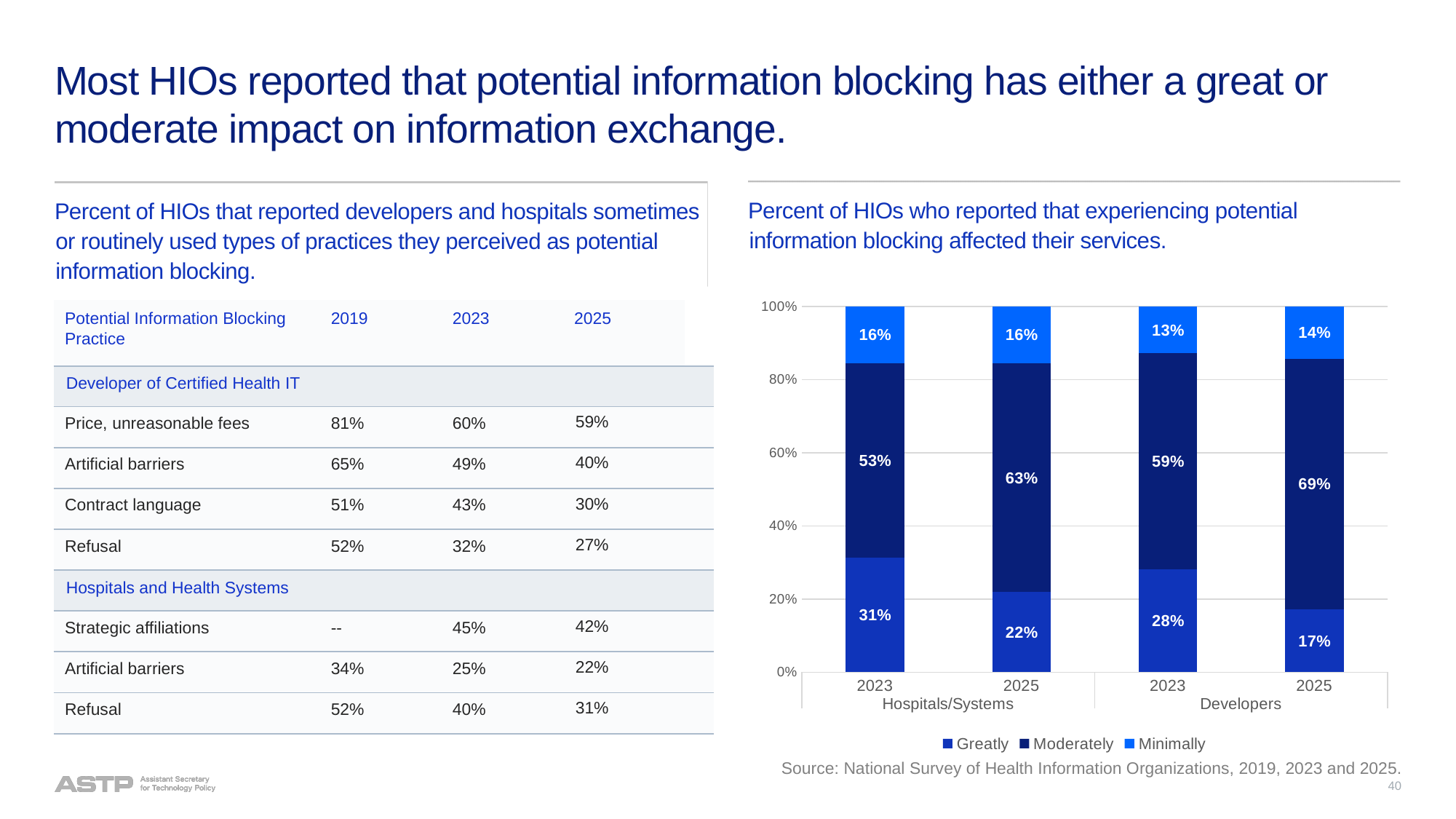
What are the three legend entries in the chart? Greatly, Moderately, Minimally In the chart, which is larger: the Greatly value for Hospitals/Systems in 2023 or the Greatly value for Developers in 2023? Hospitals/Systems 2023 In the chart, what percent of HIOs reported that potential information blocking affected their services greatly for Hospitals/Systems in 2023? 31% How many series does the chart's legend list? 3 In the chart, does the Greatly value for Developers rise or fall from 2023 to 2025? Fall In the chart, which bar has the highest Moderately value? Developers 2025 In the chart, by how many percentage points did the Moderately value for Hospitals/Systems change from 2023 to 2025? 10 percentage points In the chart, what is the Moderately value for Developers in 2025? 69% In the chart, what is the Minimally value for Developers in 2023? 13% In the chart, which bar has the lowest Greatly value? Developers 2025 What kind of chart is shown on the right of the slide? Stacked bar chart How many stacked bars are shown in the chart? 4